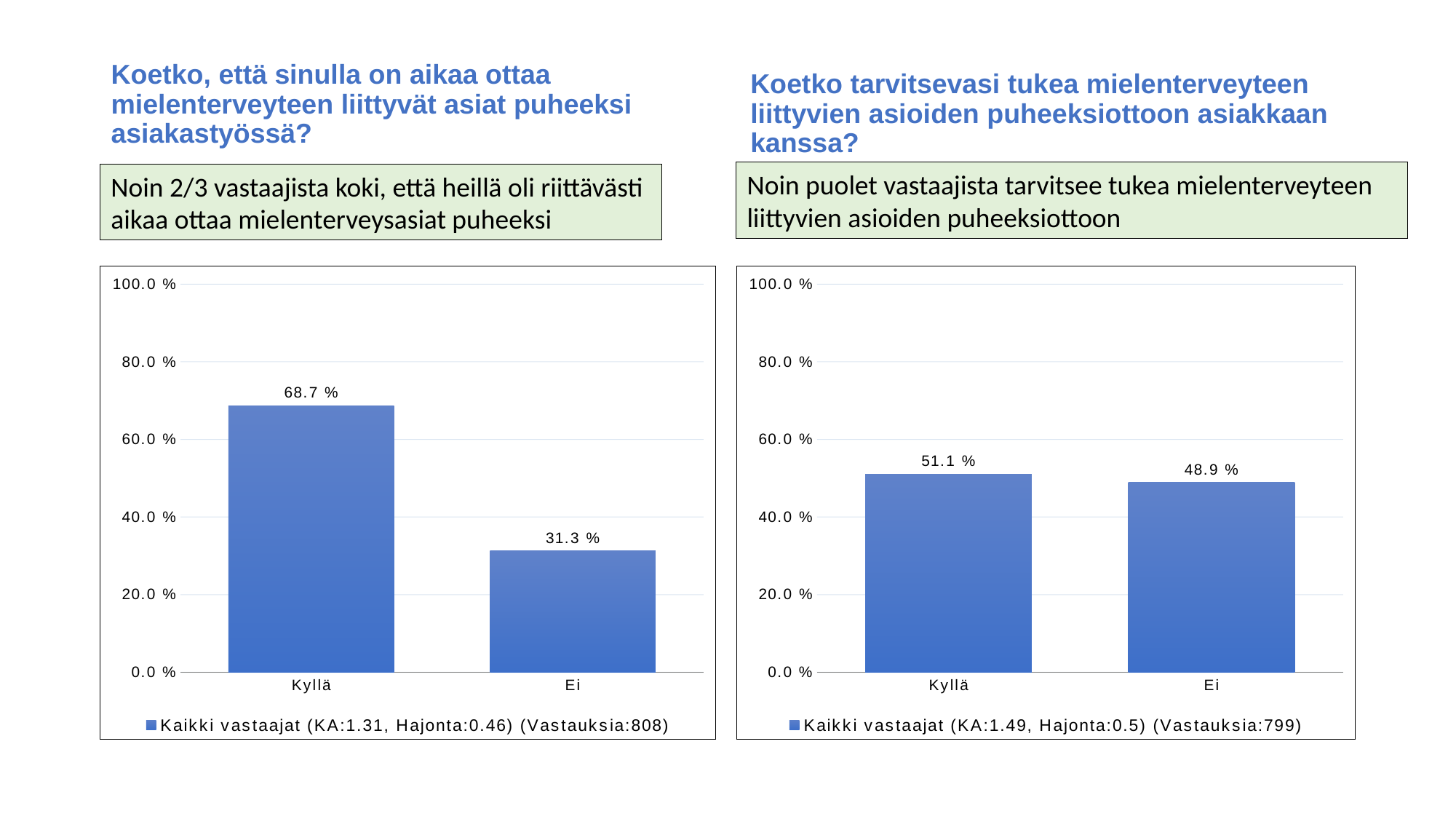
How many categories are shown in the right chart? 2 In the right chart, how many responses (Vastauksia) does the legend report? 799 In the right chart, what is the value for Kyllä? 51.1 % In the left chart, what is the difference between the values for Kyllä and Ei? 37.4 % In the right chart, what is the difference between the values for Kyllä and Ei? 2.2 % In the right chart, which category has the lowest value? Ei What kind of chart is the left chart? bar chart In the left chart, which category has the highest value? Kyllä In the left chart, what is the value for Kyllä? 68.7 % In the right chart, what is the value for Ei? 48.9 % In the left chart, what is the value for Ei? 31.3 % In the left chart, is the value for Ei greater or less than 40.0 %? less